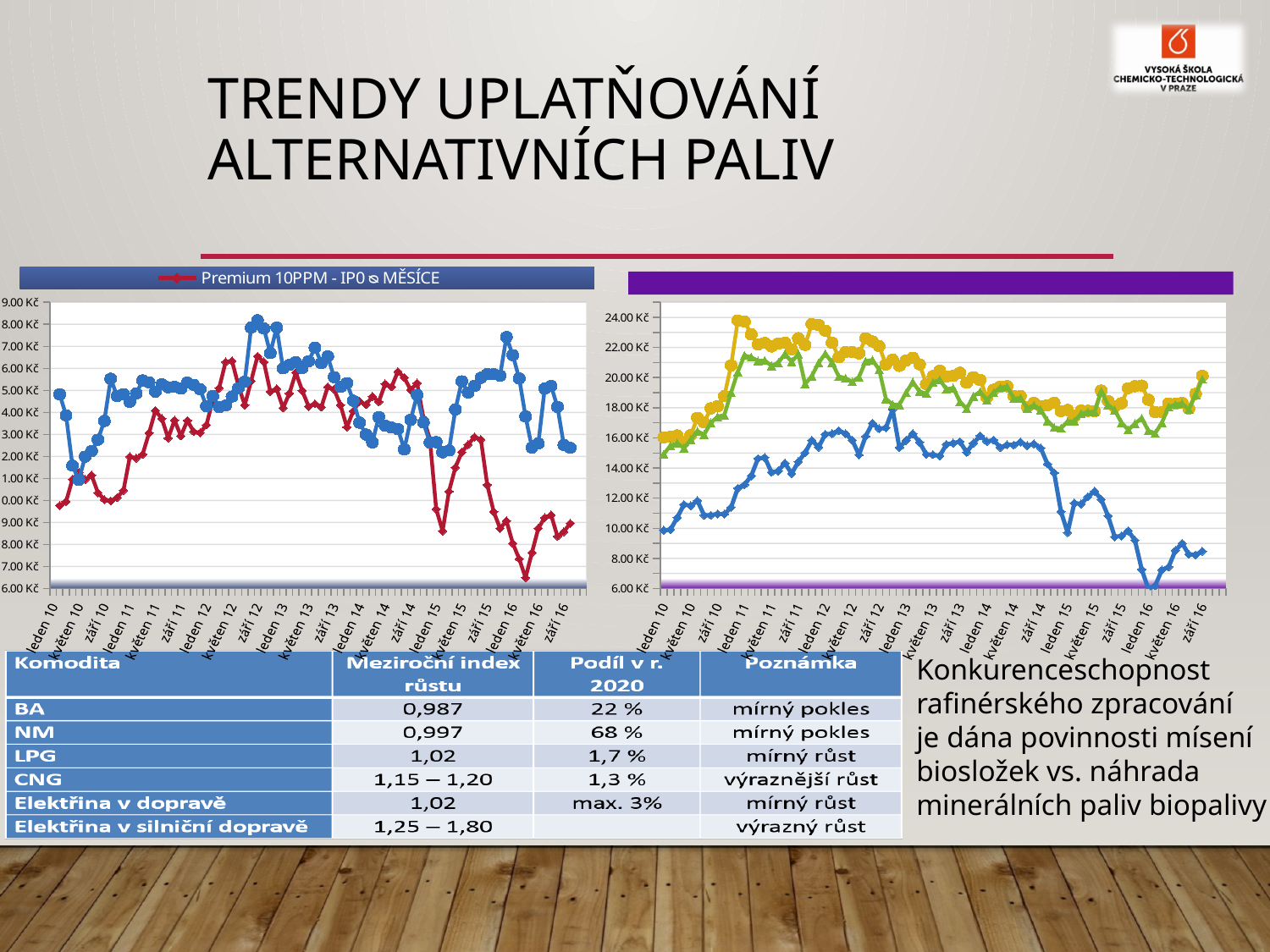
How many data series are plotted in the chart on the left of the slide? 2 What kind of chart is the chart on the right of the slide? line chart In the chart on the right, is the value of the blue series at leden 14 greater or less than 14.00 Kč? greater In the chart on the right, which series has the lowest values at the end of the period (září 16): yellow, green or blue? blue What kind of chart is the chart on the left of the slide? line chart What is the first label on the x axis of the chart on the left? leden 10 In the chart on the right, is the highest value of the yellow series greater or less than 22.00 Kč? greater In the chart on the right, does the blue series rise or fall overall from leden 10 to září 16? fall What is the highest tick value shown on the y axis of the chart on the right? 24.00 Kč In the chart on the right, which series reaches the highest value overall: yellow, green or blue? yellow In the chart on the right, is the value of the blue series at září 16 greater or less than 10.00 Kč? less How many data series are plotted in the chart on the right of the slide? 3